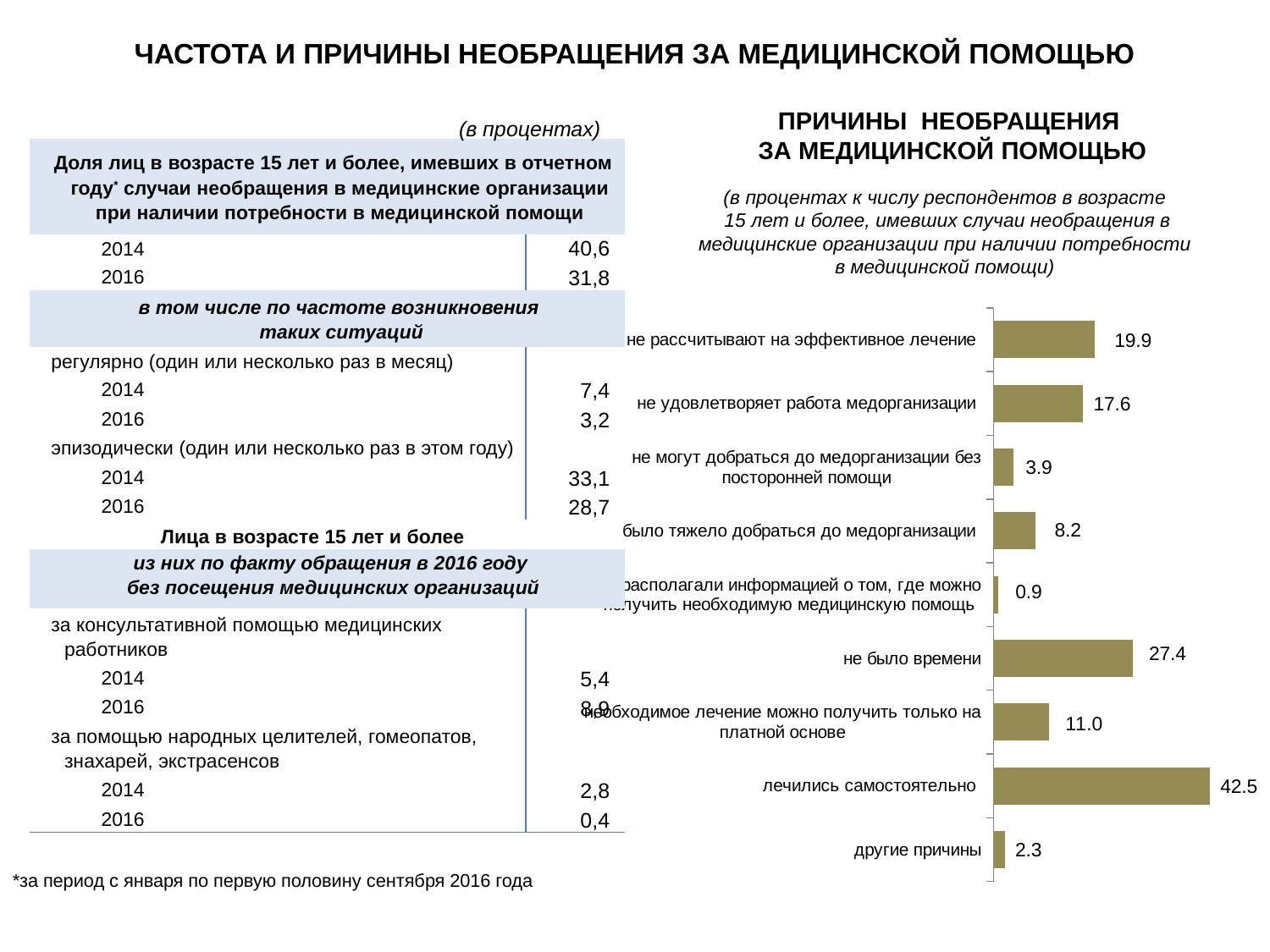
Which category has the highest value in the chart? лечились самостоятельно What is the value for "не было времени" in the chart? 27.4 How many categories (bars) are shown in the chart? 9 What is the difference between the values for "не рассчитывают на эффективное лечение" and "не удовлетворяет работа медорганизации"? 2.3 What type of chart is shown on the slide? bar chart What is the value for "другие причины" in the chart? 2.3 What is the title of the chart on the right side of the slide? ПРИЧИНЫ НЕОБРАЩЕНИЯ ЗА МЕДИЦИНСКОЙ ПОМОЩЬЮ What is the value for "лечились самостоятельно" in the chart? 42.5 What is the value for "было тяжело добраться до медорганизации" in the chart? 8.2 What is the difference between the values for "лечились самостоятельно" and "не было времени"? 15.1 Which is larger: the value for "было тяжело добраться до медорганизации" or the value for "не могут добраться до медорганизации без посторонней помощи"? было тяжело добраться до медорганизации What is the value for "не рассчитывают на эффективное лечение" in the chart? 19.9